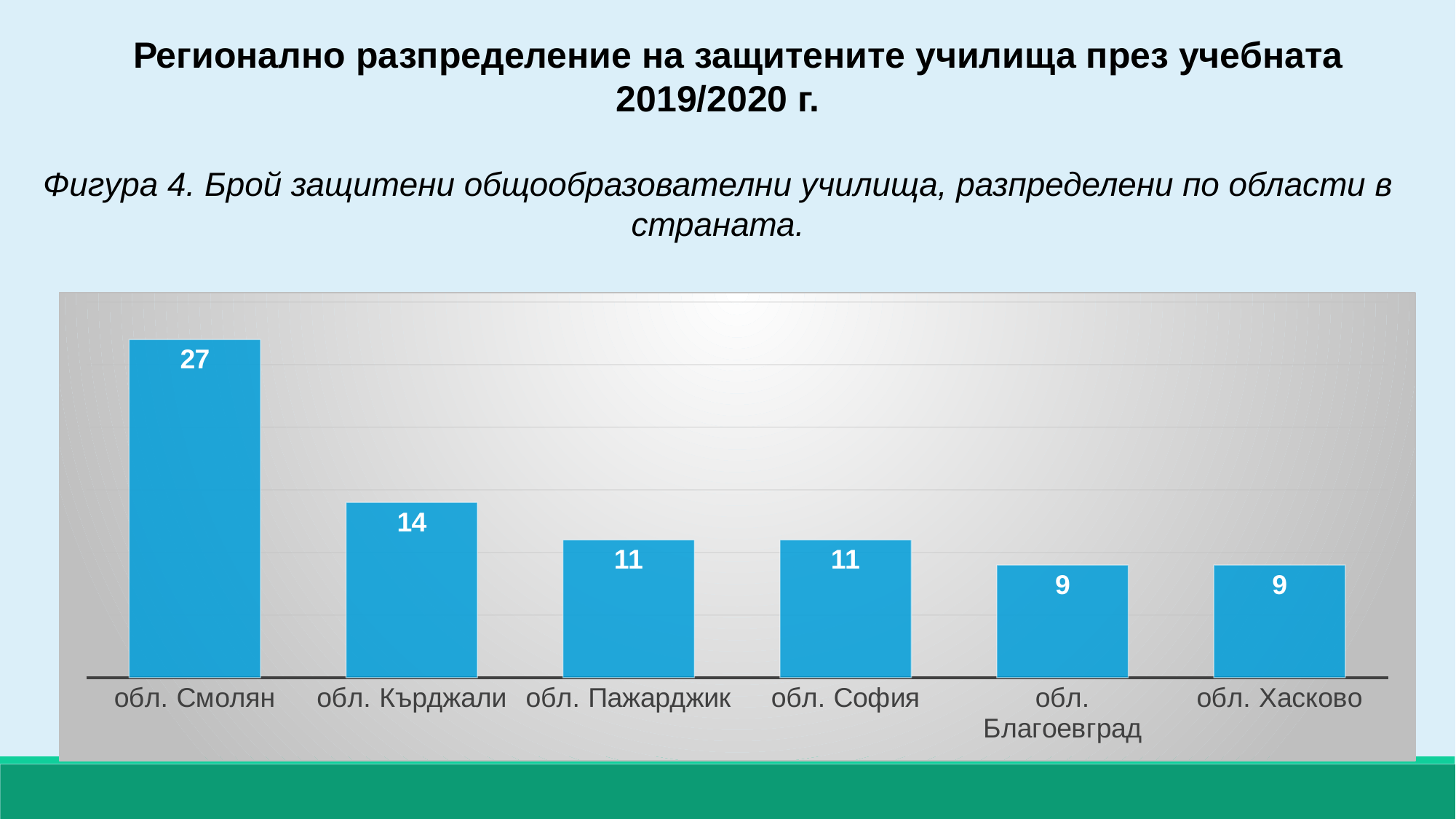
What is the difference between the values for обл. Смолян and обл. Кърджали? 13 What is the value for обл. Благоевград? 9 Which region has the highest value? обл. Смолян What is the value for обл. Кърджали? 14 Which is larger, the value for обл. Кърджали or the value for обл. София? обл. Кърджали What kind of chart is shown on the slide? bar chart What colour are the bars in the chart? blue What is the value for обл. Смолян? 27 What is the value for обл. София? 11 Do the values rise or fall from left to right across the chart? fall What is the difference between the values for обл. Пажарджик and обл. Хасково? 2 How many regions are shown on the chart? 6